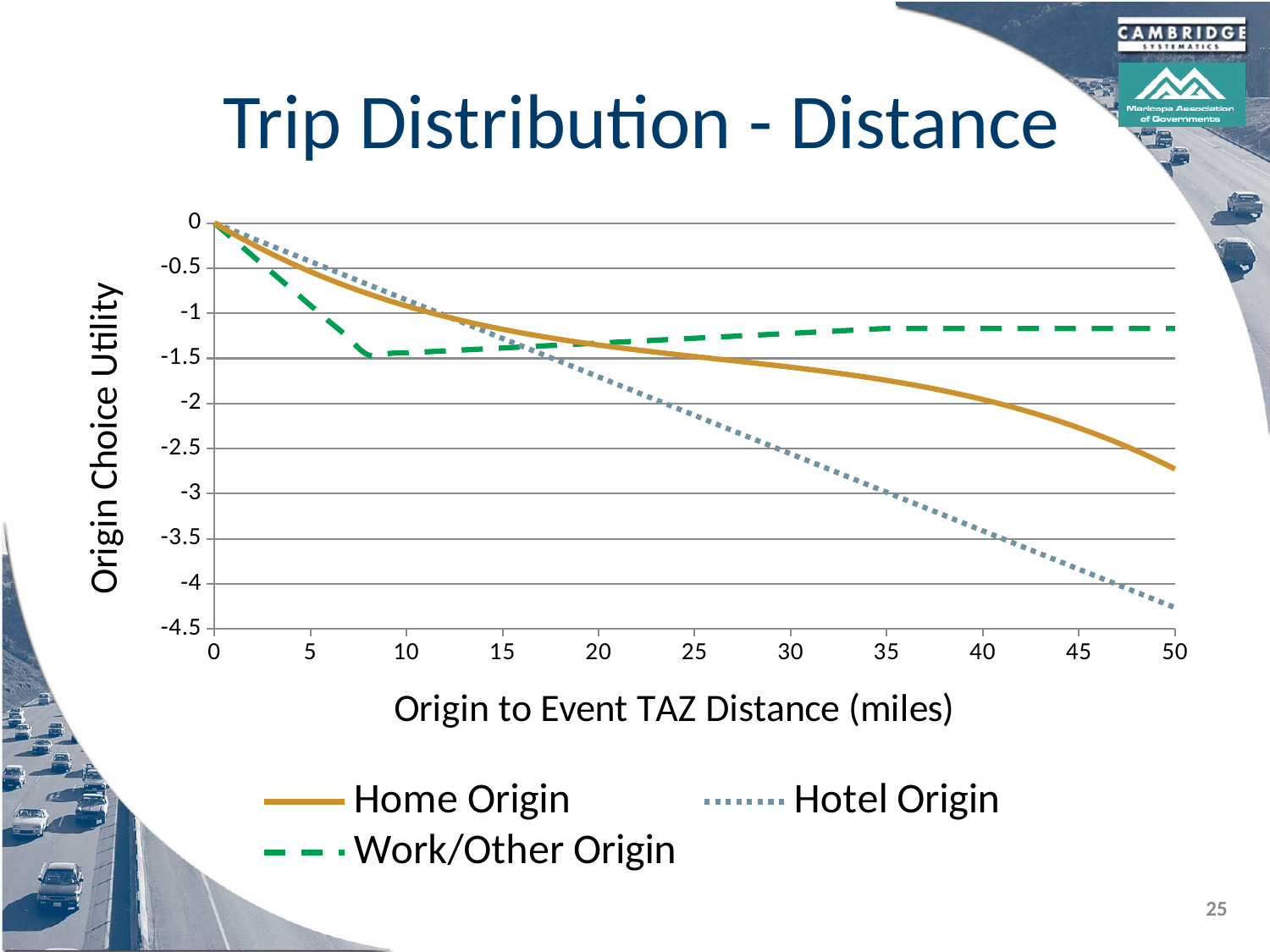
What kind of chart is shown on the slide? line chart Is the value for Hotel Origin at 50 miles greater or less than -4? less What is the title of the chart on the slide? Trip Distribution - Distance Which series has the highest Origin Choice Utility at 50 miles? Work/Other Origin What is the label of the x axis? Origin to Event TAZ Distance (miles) How many series does the legend list? 3 Is the value for Home Origin at 50 miles greater or less than -2.5? less What is the Origin Choice Utility for the Home Origin series at a distance of 0 miles? 0 At 40 miles, which series has the higher Origin Choice Utility, Home Origin or Work/Other Origin? Work/Other Origin Which series has the lowest Origin Choice Utility at 50 miles? Hotel Origin Is the value for Work/Other Origin at 50 miles greater or less than -1.5? greater Does the Hotel Origin series rise or fall as distance increases from 0 to 50 miles? fall